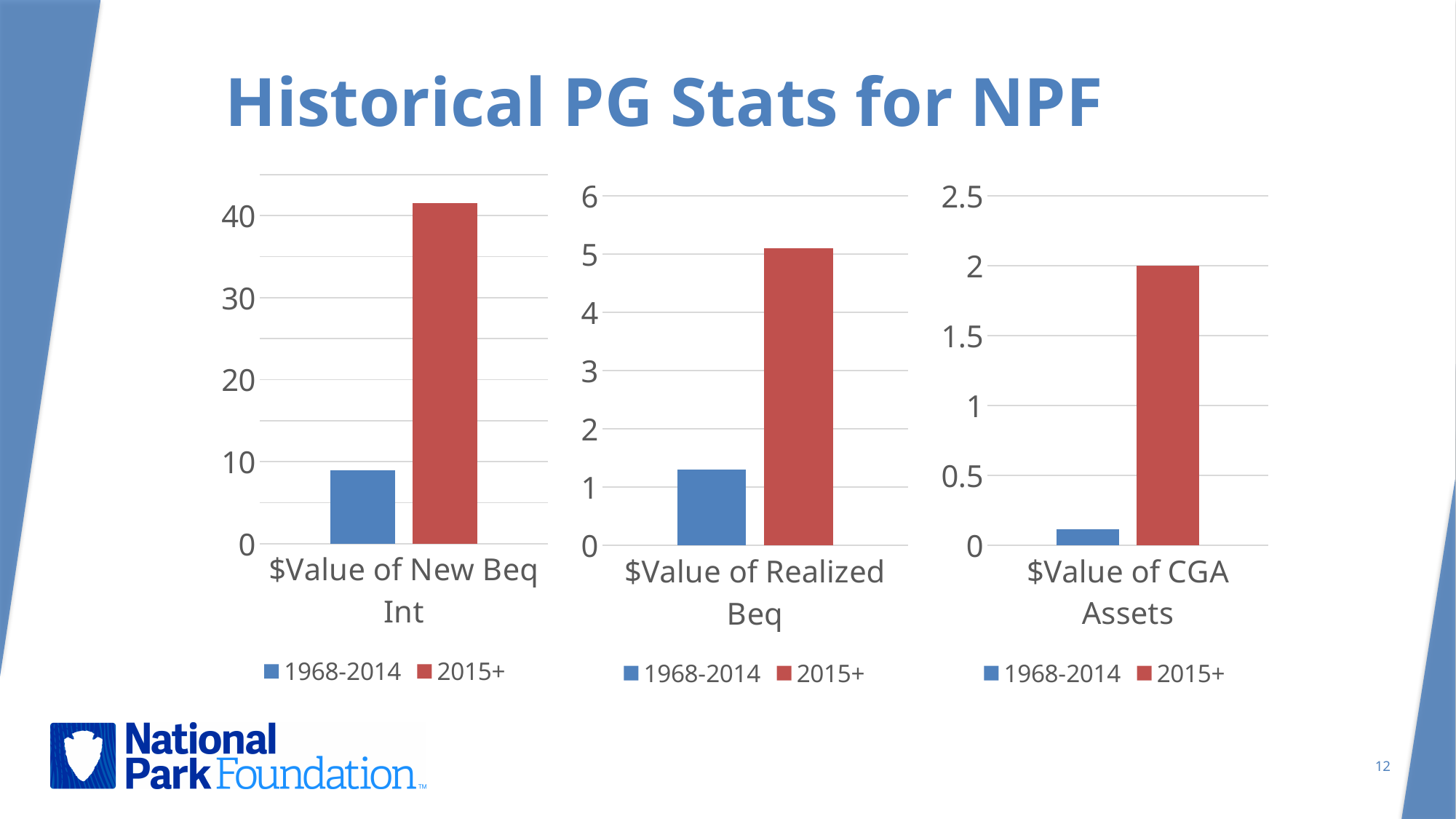
What colour represents the 2015+ series in the charts? red In the middle chart ($Value of Realized Beq), which series has the lower value? 1968-2014 In the right chart ($Value of CGA Assets), is the value for 2015+ greater or less than 1.5? greater In the right chart ($Value of CGA Assets), is the value for 1968-2014 greater or less than 0.5? less In the right chart ($Value of CGA Assets), which series has the highest value? 2015+ In the left chart ($Value of New Beq Int), is the value for 2015+ greater or less than 40? greater In the left chart ($Value of New Beq Int), which series has the higher value, 1968-2014 or 2015+? 2015+ What kind of chart is the left chart ($Value of New Beq Int)? bar chart How many series does the legend of the middle chart ($Value of Realized Beq) list? 2